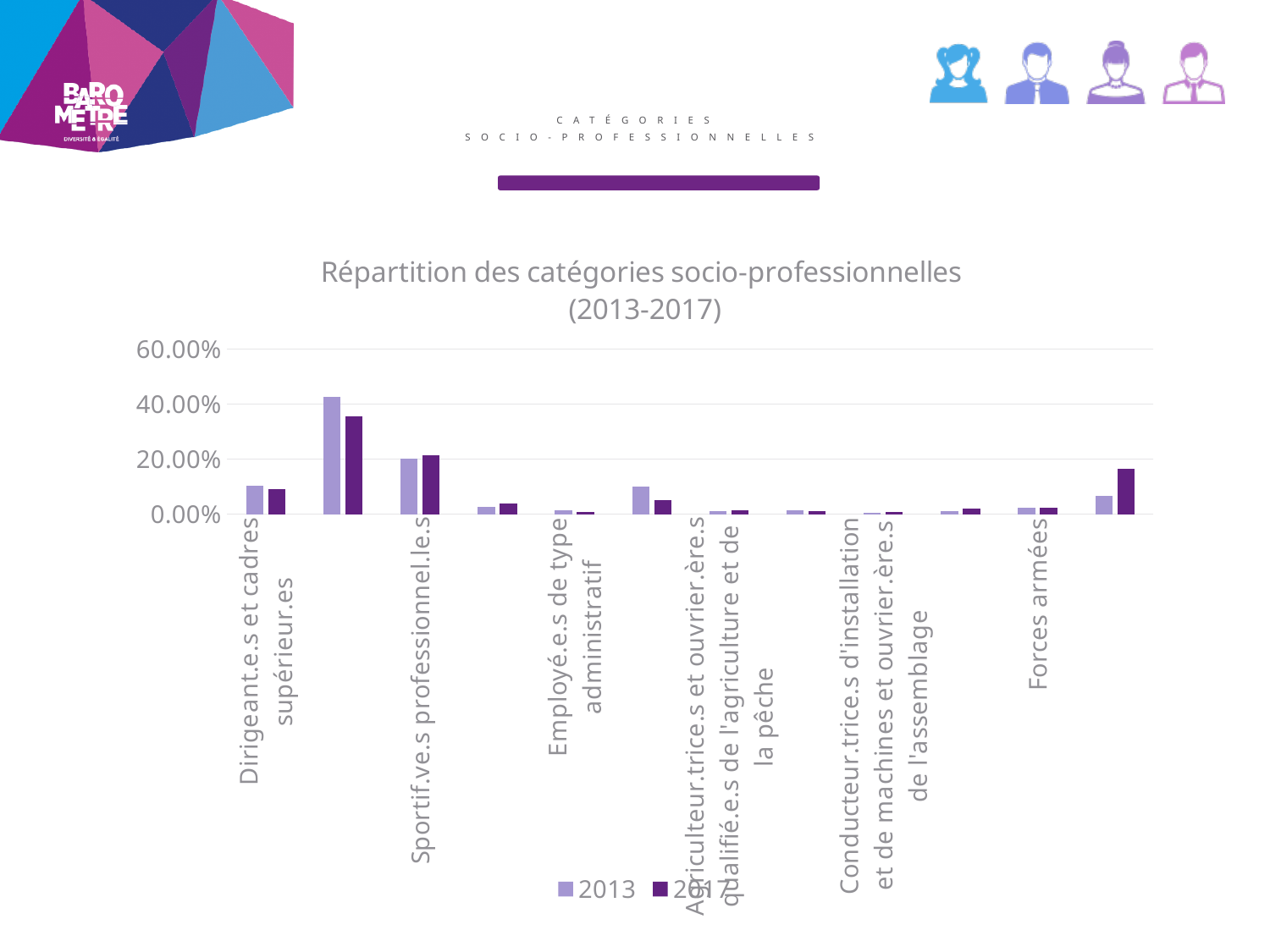
In 2017, which is larger: the value for Sportif.ve.s professionnel.le.s or for Dirigeant.e.s et cadres supérieur.es? Sportif.ve.s professionnel.le.s Is the 2017 value for Forces armées greater or less than 20.00%? less In 2013, which is larger: the value for Dirigeant.e.s et cadres supérieur.es or for Employé.e.s de type administratif? Dirigeant.e.s et cadres supérieur.es Among the categories whose labels are readable, which has the highest 2017 value? Sportif.ve.s professionnel.le.s Which years are listed in the chart legend? 2013 and 2017 Is the 2013 value for Sportif.ve.s professionnel.le.s greater or less than 40.00%? less Is the 2013 value for Dirigeant.e.s et cadres supérieur.es greater or less than 20.00%? less What kind of chart is shown on the slide? Bar chart How many groups of bars (categories) are plotted on the chart? 12 What is the title of the chart? Répartition des catégories socio-professionnelles (2013-2017) How many series does the legend list? 2